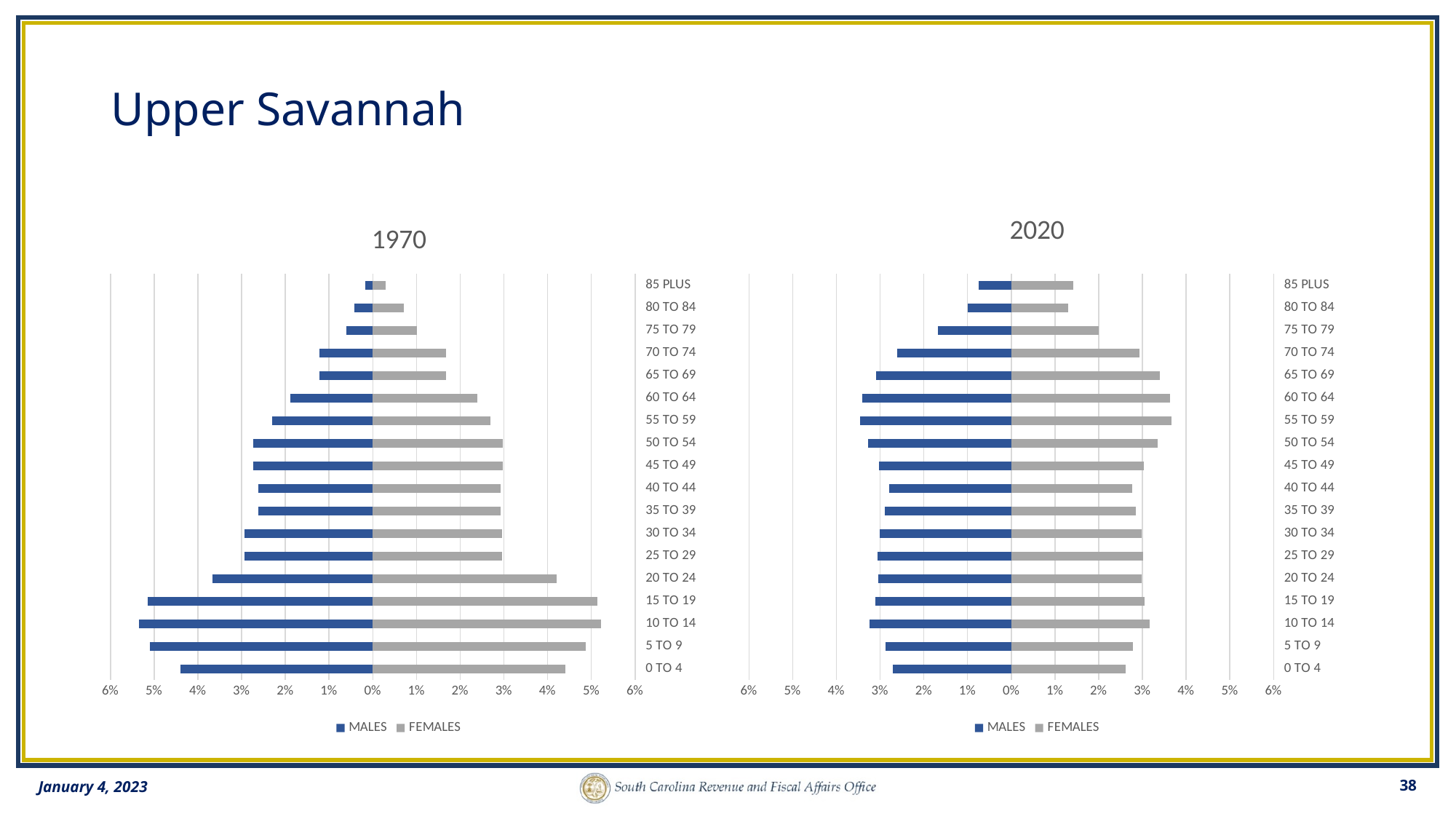
How many series does the legend of the 1970 chart list? 2 In the 1970 chart, which age group has the smallest male share? 85 PLUS What are the two series named in the legend of the 2020 chart? MALES and FEMALES In the 1970 chart, is the male value for 10 TO 14 greater or less than 5%? greater In the 1970 chart, do the male bars generally get shorter or longer moving from 20 TO 24 up to 85 PLUS? shorter In the 2020 chart, which age group has the smallest male share? 85 PLUS In the 1970 chart, which is larger, the male value for 20 TO 24 or for 25 TO 29? 20 TO 24 In the 2020 chart, is the male value for 0 TO 4 greater or less than 3%? less In the 2020 chart, is the female value for 55 TO 59 greater or less than 3%? greater How many age-group categories does the 2020 chart show? 18 What kind of chart is the 1970 chart? bar chart